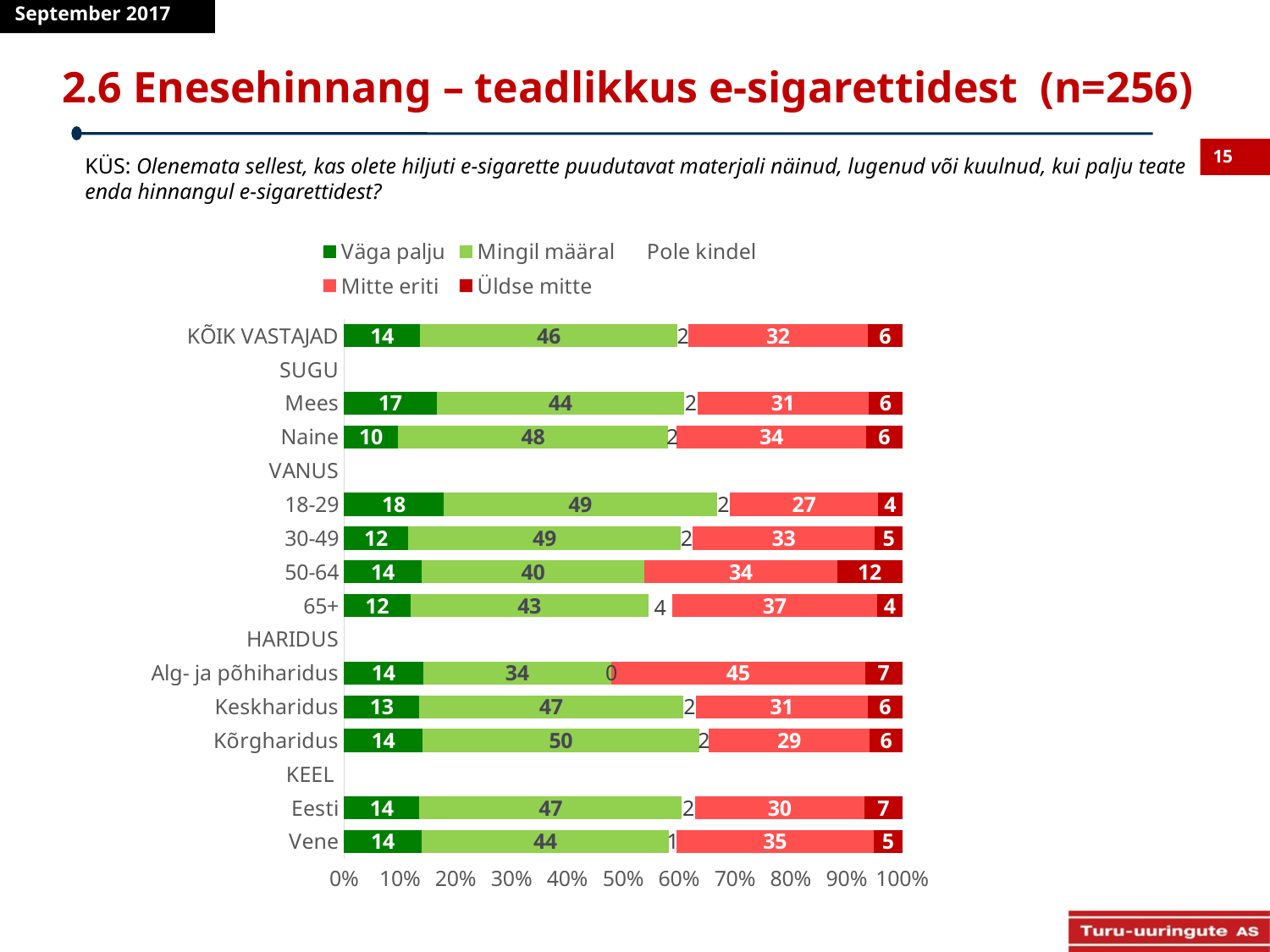
What is the difference between the "Mingil määral" values for Kõrgharidus and Alg- ja põhiharidus? 16 What is the value of "Väga palju" for the 18-29 age group? 18 Which category has the highest value for "Mitte eriti"? Alg- ja põhiharidus What is the value of "Pole kindel" for the 65+ age group? 4 Which category has the lowest value for "Väga palju"? Naine Which category has the highest value for "Väga palju"? 18-29 Which has a larger "Mitte eriti" value, Mees or Naine? Naine How many series does the legend list? 5 What kind of chart is shown on the slide? Stacked bar chart What is the total of the stacked bar for Mees? 100 What is the value of "Mitte eriti" for Alg- ja põhiharidus? 45 What is the value of "Üldse mitte" for the 50-64 age group? 12